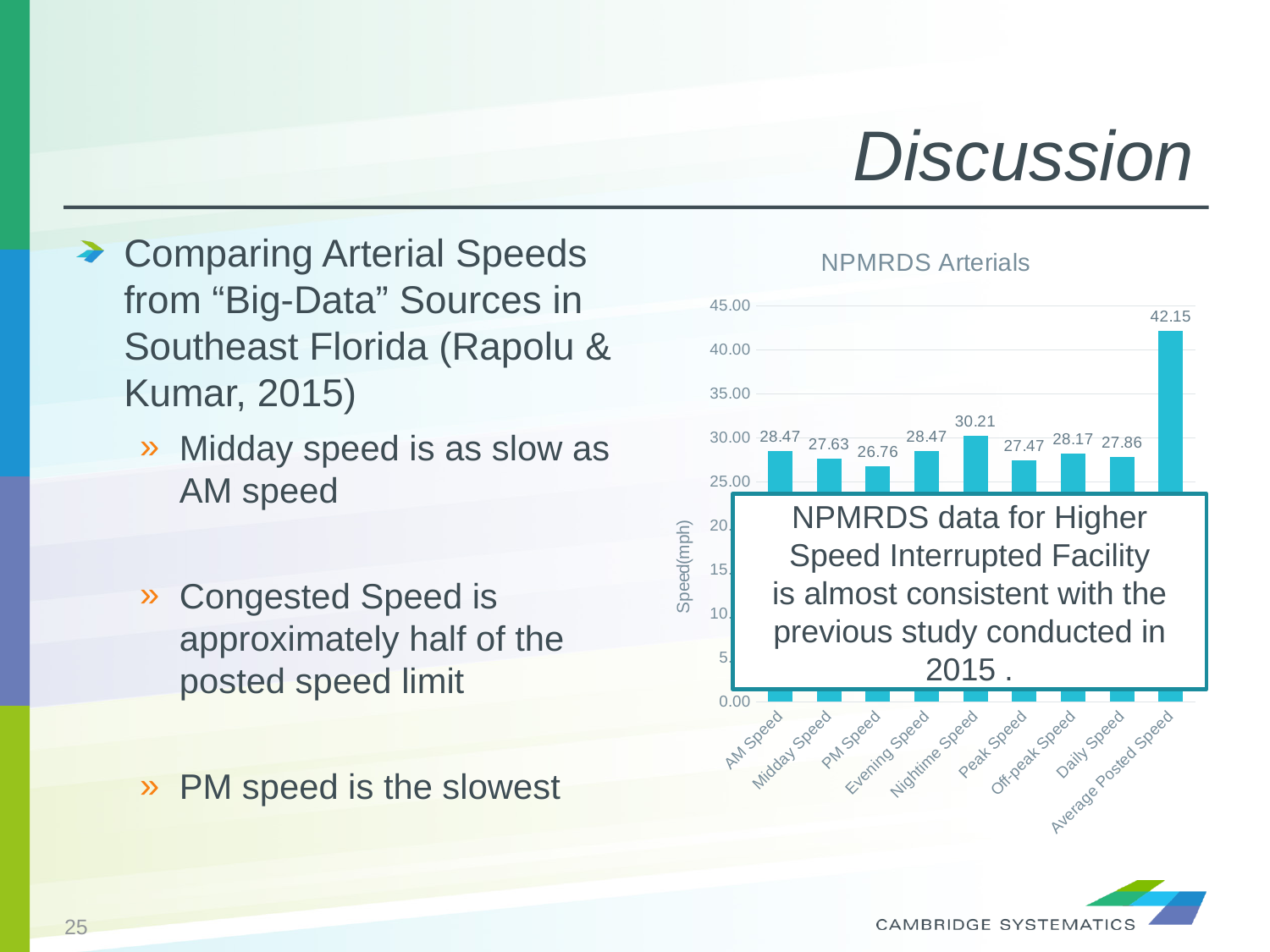
Is the value for Average Posted Speed in the NPMRDS Arterials chart greater or less than 40.00? greater What is the value for Average Posted Speed in the NPMRDS Arterials chart? 42.15 What is the difference between Average Posted Speed and Nighttime Speed in the NPMRDS Arterials chart? 11.94 What kind of chart is the NPMRDS Arterials chart? bar chart What is the label of the vertical axis in the NPMRDS Arterials chart? Speed(mph) What is the value for Midday Speed in the NPMRDS Arterials chart? 27.63 Which is larger in the NPMRDS Arterials chart, Nighttime Speed or Peak Speed? Nighttime Speed How many categories are shown in the NPMRDS Arterials chart? 9 What is the value for Nighttime Speed in the NPMRDS Arterials chart? 30.21 What is the value for PM Speed in the NPMRDS Arterials chart? 26.76 Which category has the highest value in the NPMRDS Arterials chart? Average Posted Speed Which category has the lowest value in the NPMRDS Arterials chart? PM Speed